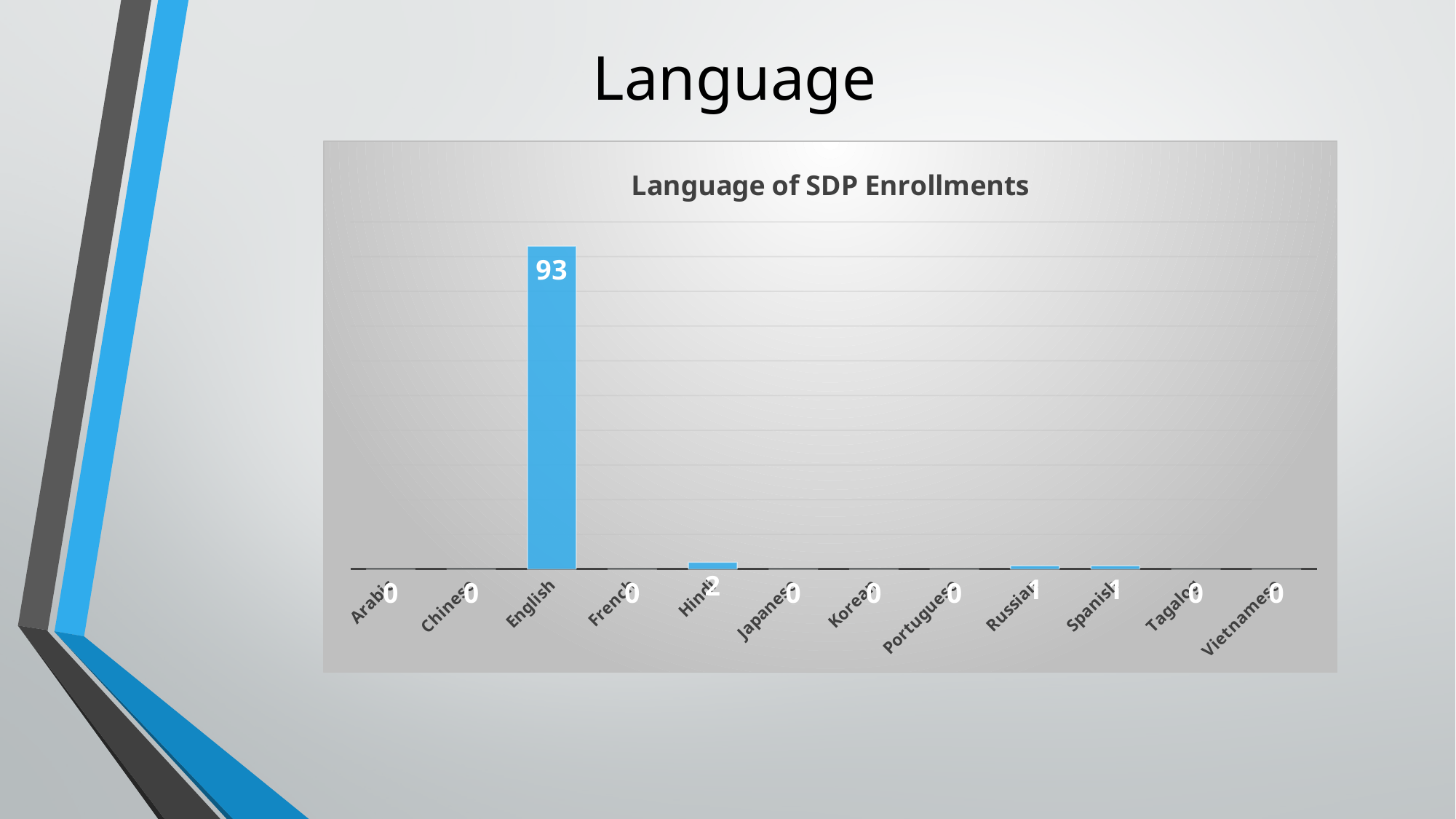
How many language categories are shown on the x axis of the chart? 12 What is the value for English in the Language of SDP Enrollments chart? 93 What is the value for Arabic in the Language of SDP Enrollments chart? 0 How many languages in the chart have a value of 0? 8 What is the title of the chart on the slide? Language of SDP Enrollments What is the value for Spanish in the Language of SDP Enrollments chart? 1 Which language has the highest number of SDP enrollments? English What is the value for Russian in the Language of SDP Enrollments chart? 1 What is the value for Hindi in the Language of SDP Enrollments chart? 2 Which is larger, the value for Hindi or the value for Spanish? Hindi What is the difference between the values for English and Hindi? 91 What kind of chart is shown on the slide? Bar chart